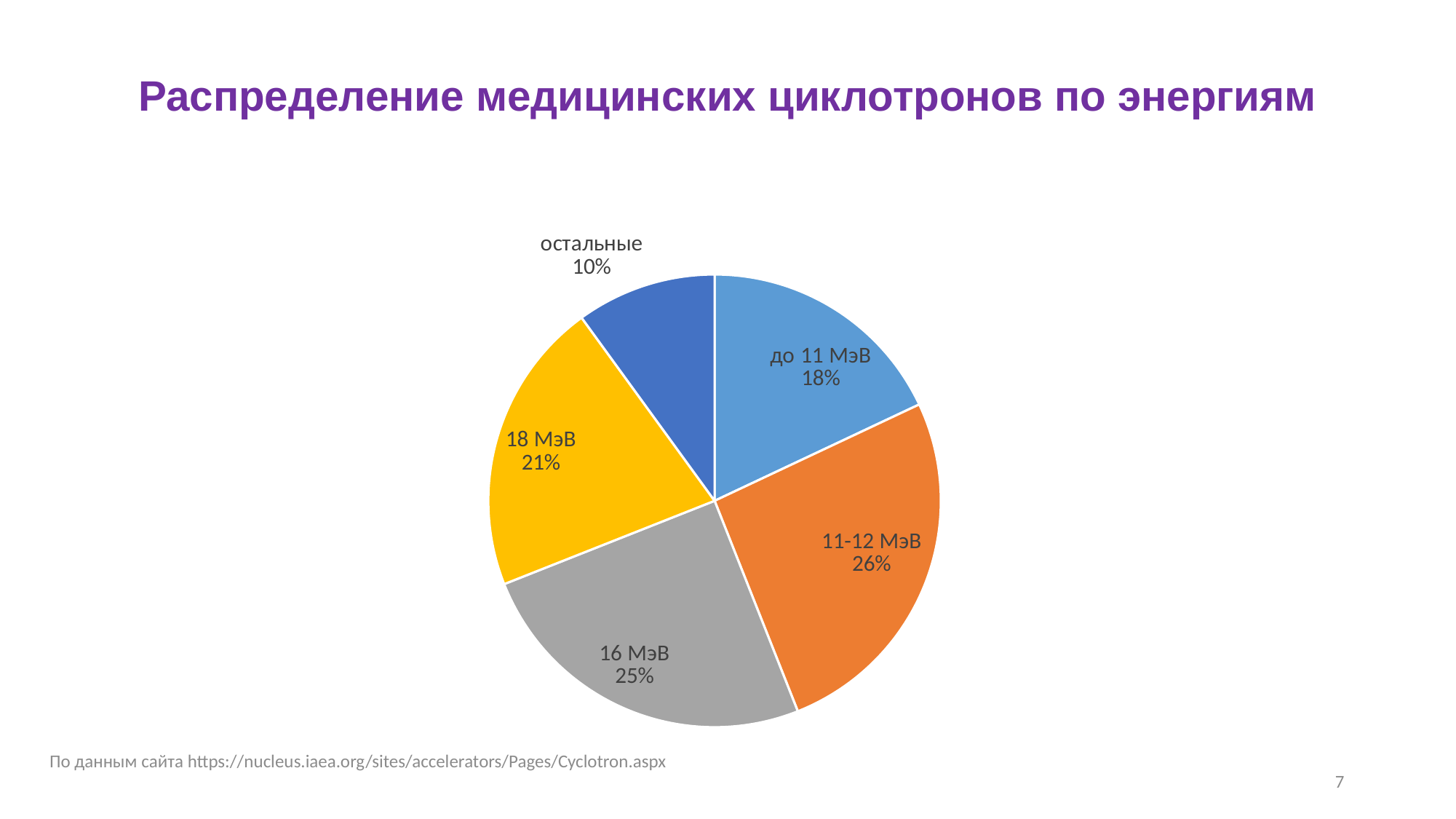
What is the difference in percentage points between the 16 МэВ and до 11 МэВ slices? 7 What type of chart is shown on the slide? pie chart Which category has the smallest share of the pie? остальные How many slices does the pie chart have? 5 What share of medical cyclotrons have energy 18 МэВ? 21% What share of medical cyclotrons have energy 11-12 МэВ? 26% What is the title of the chart on the slide? Распределение медицинских циклотронов по энергиям What share of medical cyclotrons have energy 16 МэВ? 25% What share of medical cyclotrons have energy до 11 МэВ? 18% What share is labelled 'остальные'? 10% Which is larger: the share for 18 МэВ or the share for до 11 МэВ? 18 МэВ Which category has the largest share of the pie? 11-12 МэВ